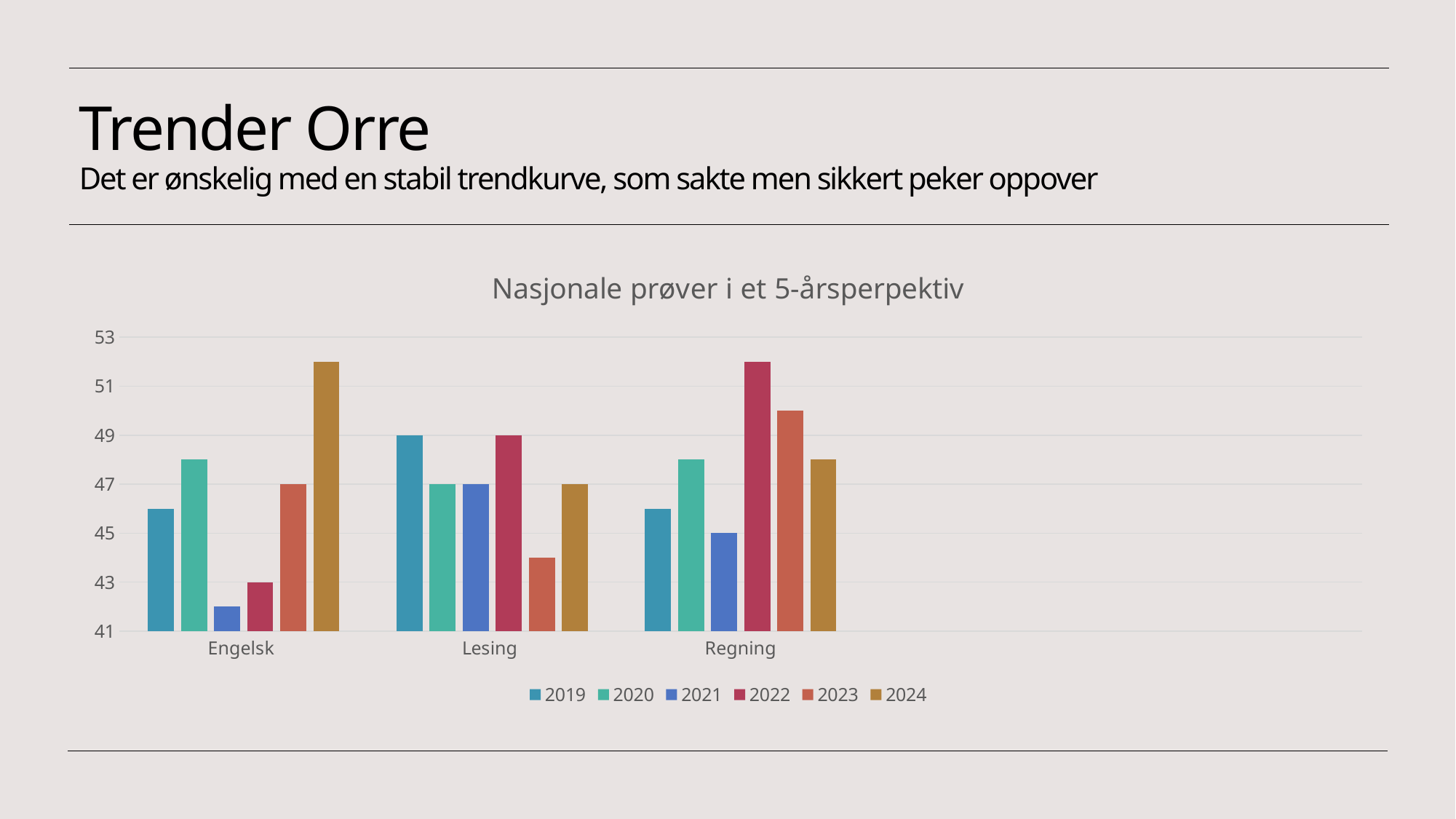
Which year has the lowest value in the Lesing category? 2023 What is the title of the chart? Nasjonale prøver i et 5-årsperpektiv Which year has the highest value in the Regning category? 2022 What is the value for 2021 in the Regning category? 45 What is the value for 2023 in the Engelsk category? 47 Which year has the highest value in the Engelsk category? 2024 Is the value for 2021 in the Engelsk category greater or less than 43? less How many series does the legend list? 6 What kind of chart is shown on the slide? bar chart What is the value for 2019 in the Lesing category? 49 How many categories are shown on the x axis? 3 In the Regning category, which is larger, the value for 2023 or the value for 2024? 2023